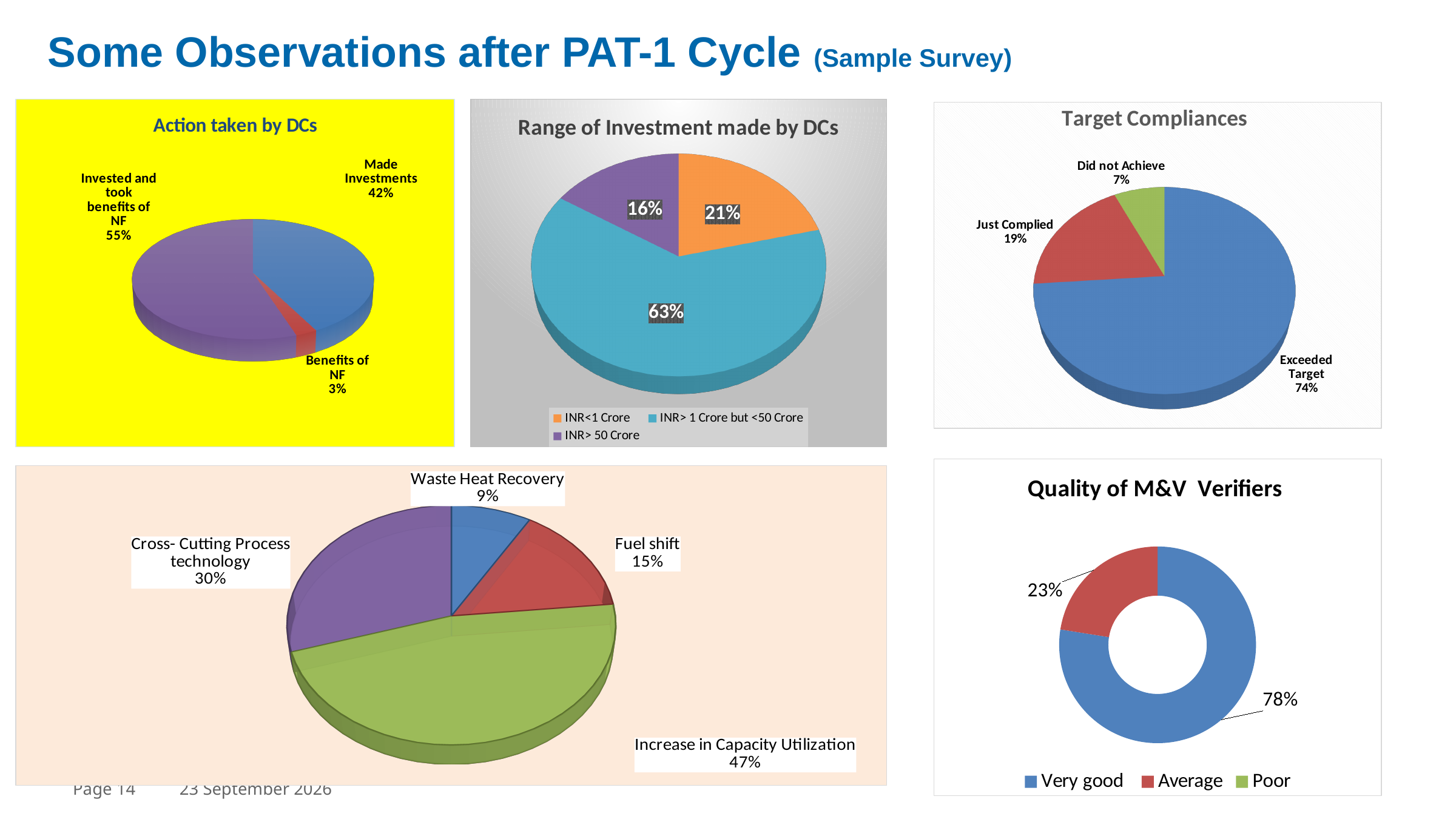
In the 'Action taken by DCs' chart, which category has the smallest share? Benefits of NF In the 'Target Compliances' chart, which is larger: 'Just Complied' or 'Did not Achieve'? Just Complied In the 'Range of Investment made by DCs' chart, what is the difference between the 'INR<1 Crore' share and the 'INR> 50 Crore' share? 5% In the 'Quality of M&V Verifiers' chart, what share is shown for the 'Very good' segment? 78% In the 'Target Compliances' chart, what share is labelled 'Just Complied'? 19% What kind of chart is 'Quality of M&V Verifiers'? Doughnut chart In the bottom-left pie chart, what share is shown for 'Increase in Capacity Utilization'? 47% In the 'Target Compliances' chart, which category has the largest share? Exceeded Target In the 'Action taken by DCs' chart, what share is labelled 'Invested and took benefits of NF'? 55% How many entries does the legend of the 'Range of Investment made by DCs' chart list? 3 How many slices are labelled in the bottom-left pie chart? 4 In the 'Range of Investment made by DCs' chart, what share is shown for 'INR> 1 Crore but <50 Crore'? 63%